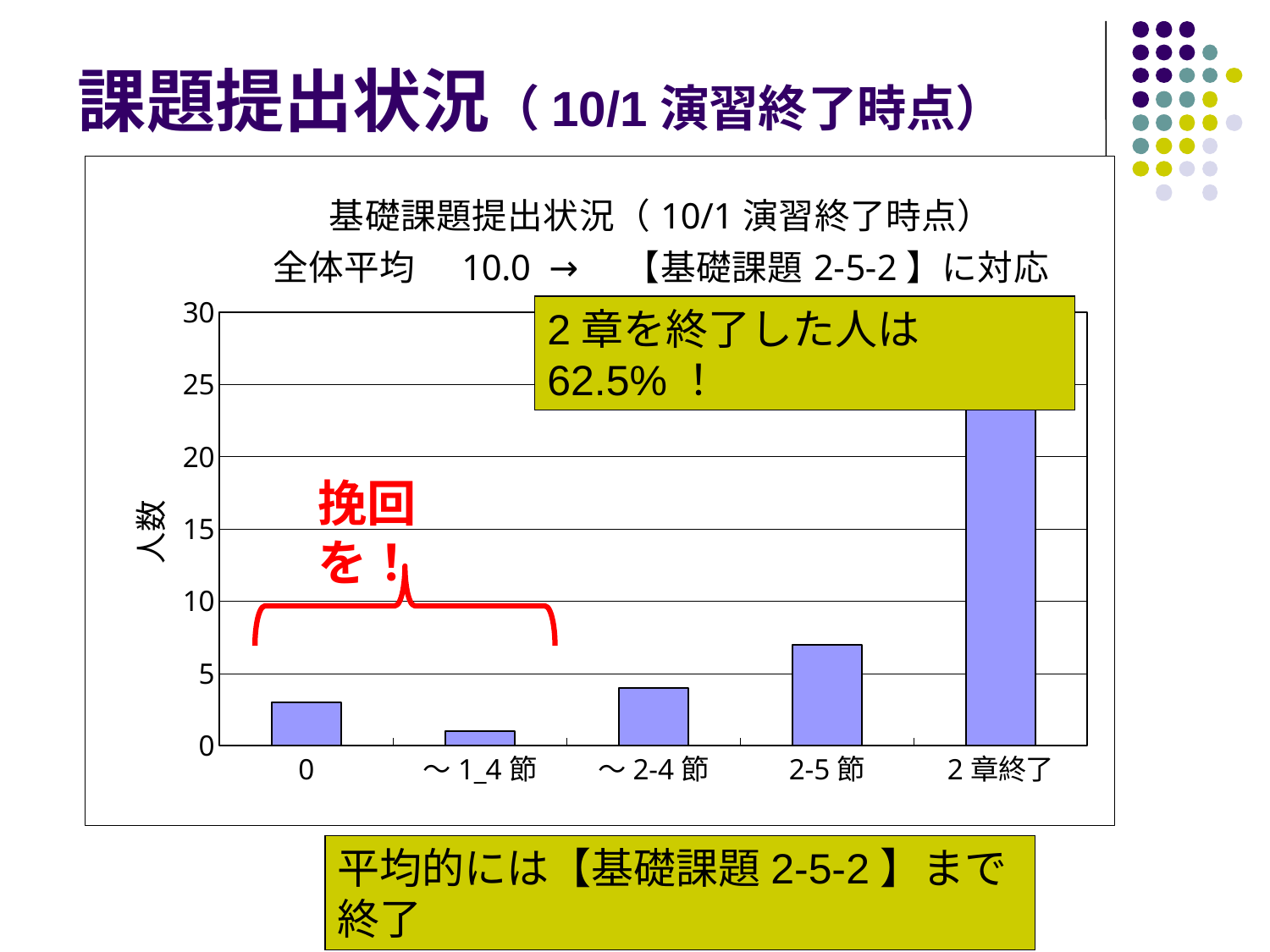
Which category has the lowest bar in the chart? ～1_4節 Which category has the highest bar in the chart? 2章終了 Is the value for 2章終了 greater or less than 20? greater How many categories are shown on the x axis of the chart? 5 Is the value for ～2-4節 greater or less than 5? less Which category has a taller bar, 0 or ～1_4節? 0 What is the title of the chart? 基礎課題提出状況（10/1 演習終了時点） 全体平均 10.0 → 【基礎課題 2-5-2】に対応 Is the value for 2-5節 greater or less than 5? greater Which category has a taller bar, 2-5節 or ～2-4節? 2-5節 What kind of chart is shown on the slide? bar chart What is the label of the y axis of the chart? 人数